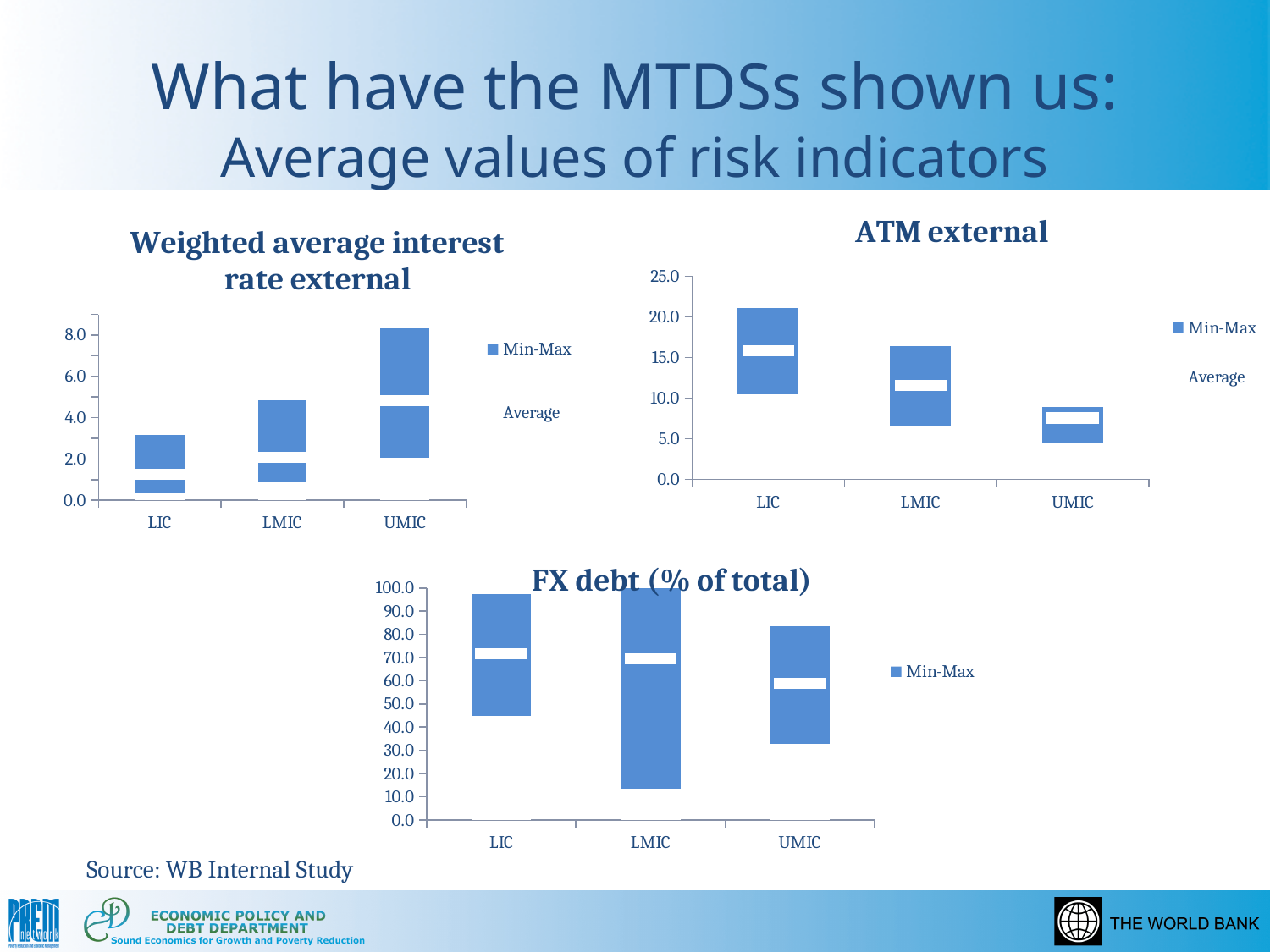
In the 'FX debt (% of total)' chart, is the minimum value for LMIC greater or less than 20.0? less In the 'ATM external' chart, is the maximum value for UMIC greater or less than 10.0? less How many series does the legend of the 'ATM external' chart list? 2 In the 'ATM external' chart, which category has the highest maximum value? LIC In the 'Weighted average interest rate external' chart, is the top of the UMIC range greater or less than 6.0? greater How many categories are shown on the x axis of the 'FX debt (% of total)' chart? 3 What is the title of the chart at the bottom of the slide? FX debt (% of total) In the 'FX debt (% of total)' chart, which category has the lowest minimum value? LMIC In the 'ATM external' chart, which category has the lowest maximum value? UMIC What kind of chart is the 'Weighted average interest rate external' chart? bar chart